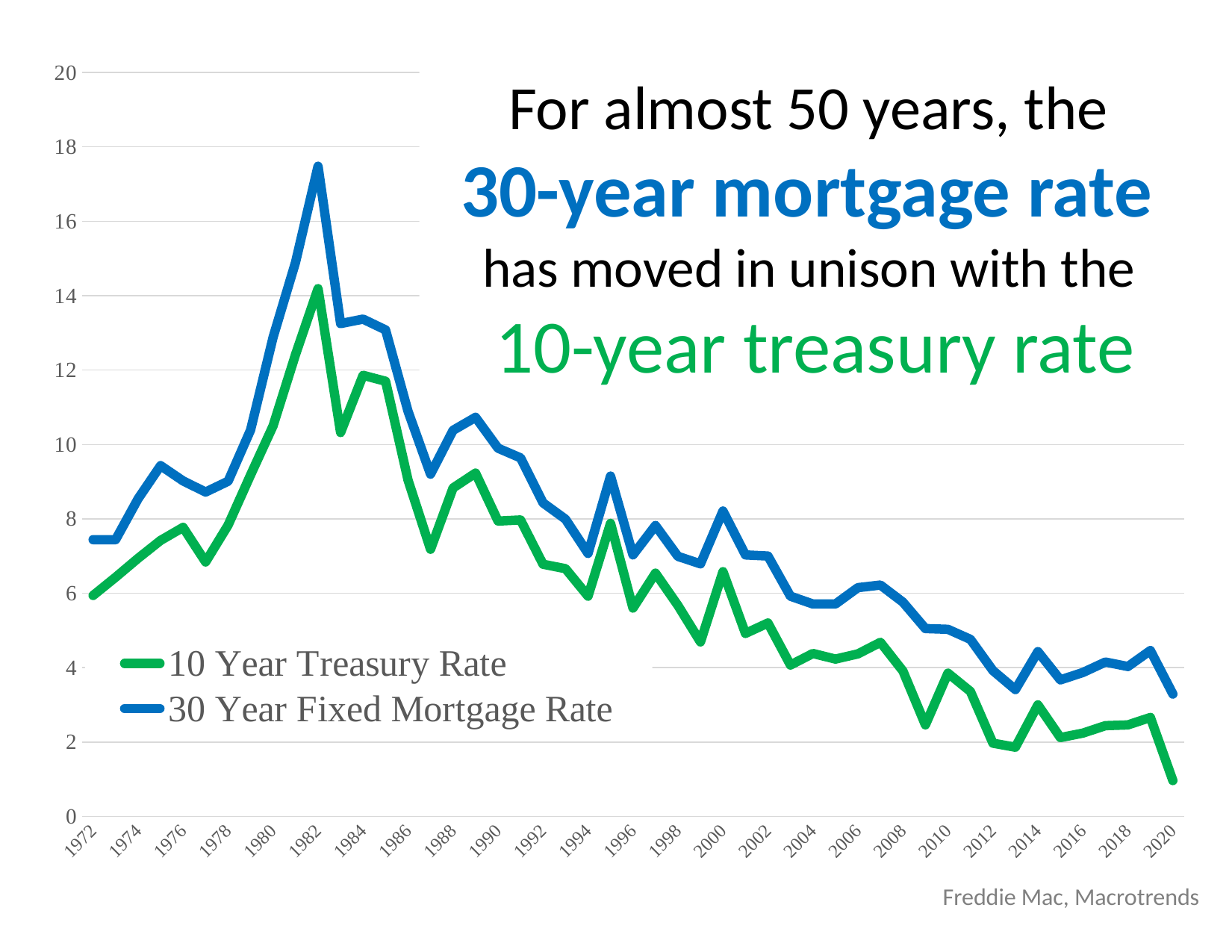
In which year does the 30 Year Fixed Mortgage Rate reach its highest value? 1982 Which colour is used for the 30 Year Fixed Mortgage Rate line? blue Is the value for the 30 Year Fixed Mortgage Rate in 1982 greater or less than 16? greater In 1982, which series has the higher value, the 10 Year Treasury Rate or the 30 Year Fixed Mortgage Rate? 30 Year Fixed Mortgage Rate In which year does the 10 Year Treasury Rate reach its lowest value? 2020 What are the two series named in the legend? 10 Year Treasury Rate and 30 Year Fixed Mortgage Rate Is the value for the 30 Year Fixed Mortgage Rate in 2020 greater or less than 4? less From 1982 to 2020, do the values of the 30 Year Fixed Mortgage Rate generally rise or fall? fall How many series does the legend list? 2 What kind of chart is shown on the slide? line chart In which year does the 10 Year Treasury Rate reach its highest value? 1982 Is the value for the 10 Year Treasury Rate in 2020 greater or less than 2? less